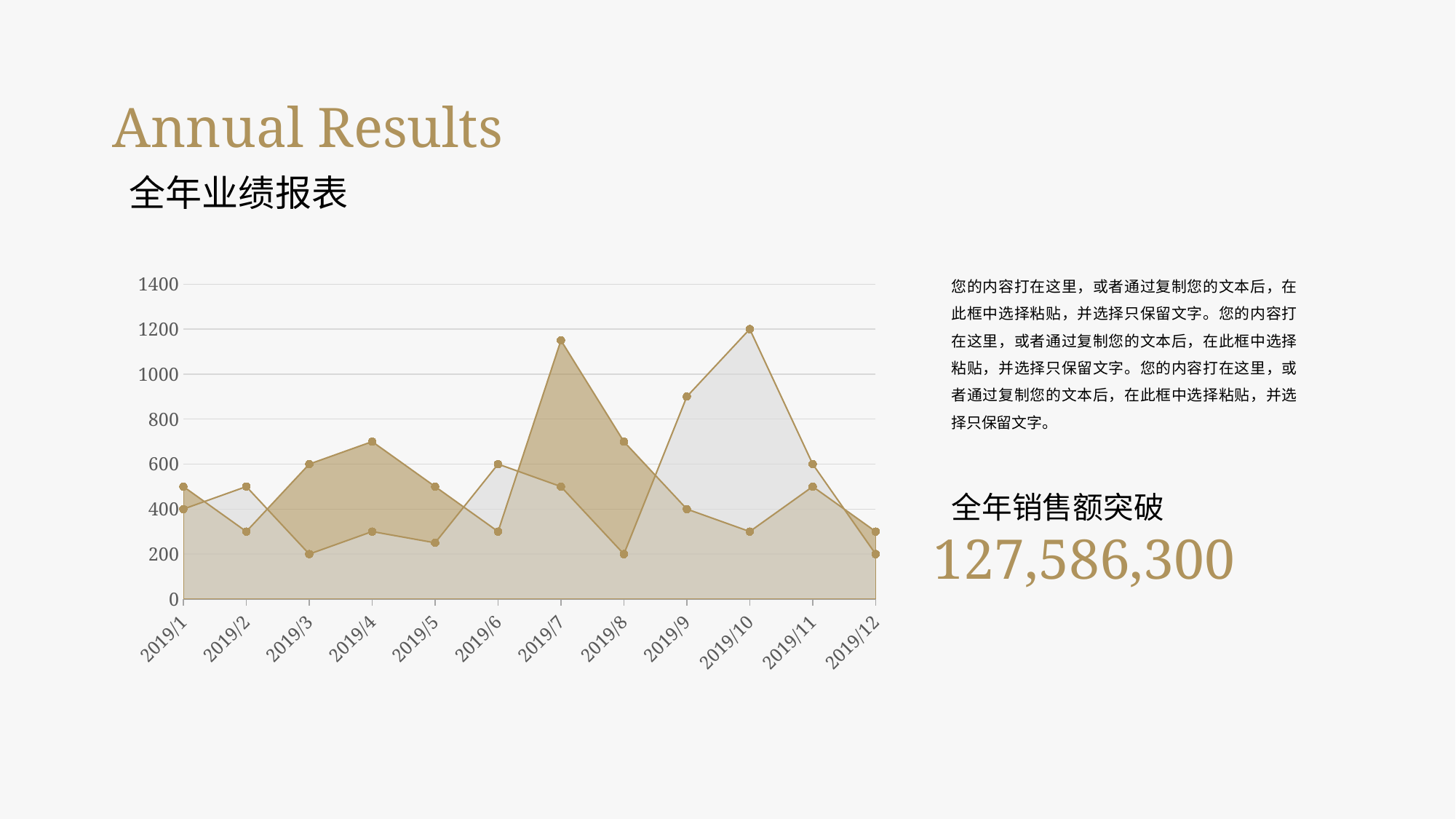
Does the upper series rise or fall from 2019/10 to 2019/12? fall What is the lower of the two values plotted at 2019/8? 200 In which month does the chart reach its highest value? 2019/10 What is the lowest value plotted on the chart? 200 Is the higher value plotted at 2019/7 greater or less than 1000? greater How many months are shown on the x axis of the chart? 12 What is the lower of the two values plotted at 2019/1? 400 What is the difference between the highest value on the chart (at 2019/10) and the lowest value on the chart? 1000 What kind of chart is shown on the slide? area chart How many data series are plotted in the chart? 2 What is the highest value plotted on the chart, reached at 2019/10? 1200 Which month has the higher top value, 2019/4 or 2019/9? 2019/9